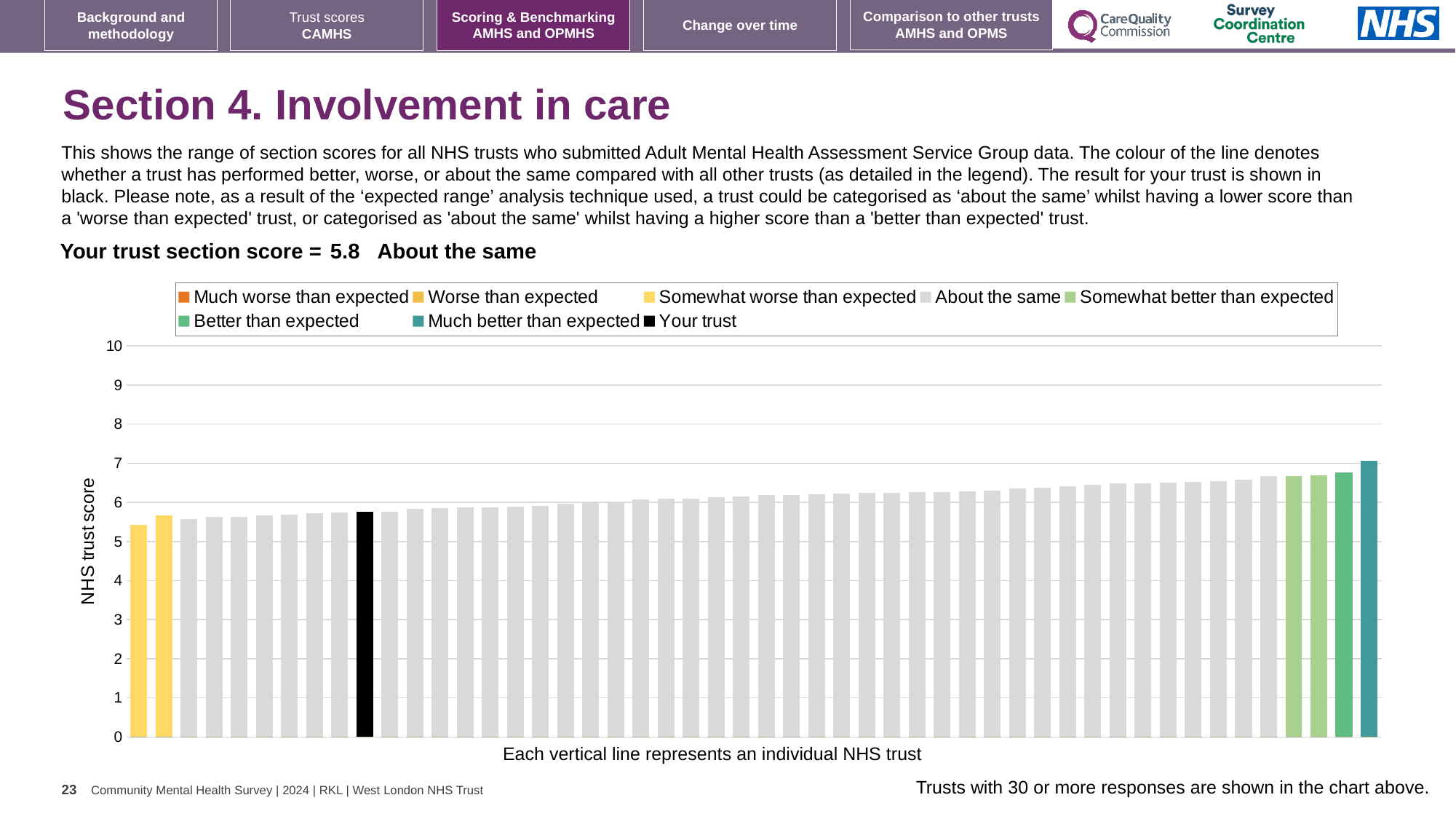
Is the value of the shortest bar in the chart greater or less than 6? less Which legend category does the tallest bar belong to? Much better than expected What is your trust's section score for Involvement in care, as printed on the slide? 5.8 What kind of chart is shown on the slide? Bar chart Is the value for your trust's bar greater or less than 5? greater Which legend category does the shortest bar belong to? Somewhat worse than expected How many bars are coloured as 'Somewhat worse than expected'? 2 What is the label on the vertical axis of the chart? NHS trust score Is the value of the tallest bar in the chart greater or less than 6? greater How is your trust's section score categorised compared with other trusts? About the same How many entries does the chart legend list? 8 Do the bar values rise or fall from left to right along the x axis? Rise